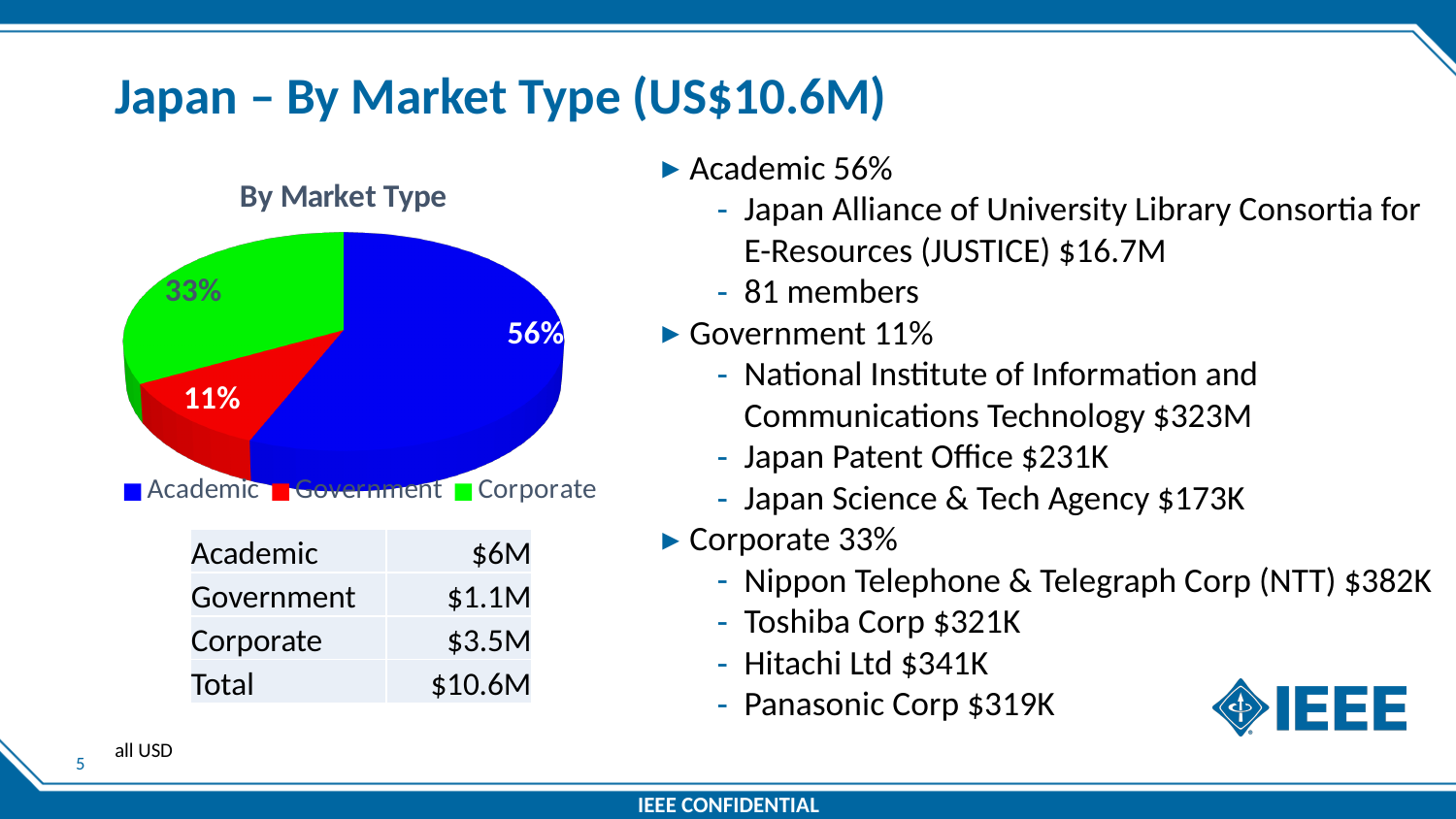
What is the difference in percentage points between the Academic and Corporate slices? 23 How many entries does the legend list? 3 What share of the pie does Corporate represent? 33% Which market type has the largest slice of the pie? Academic Which market type has the smallest slice of the pie? Government What share of the pie does Academic represent? 56% Which slice is larger, Corporate or Government? Corporate What colour is the Corporate slice in the pie chart? green What is the title of the chart? By Market Type What share of the pie does Government represent? 11% What type of chart is shown on the slide? pie chart How many slices does the pie chart have? 3